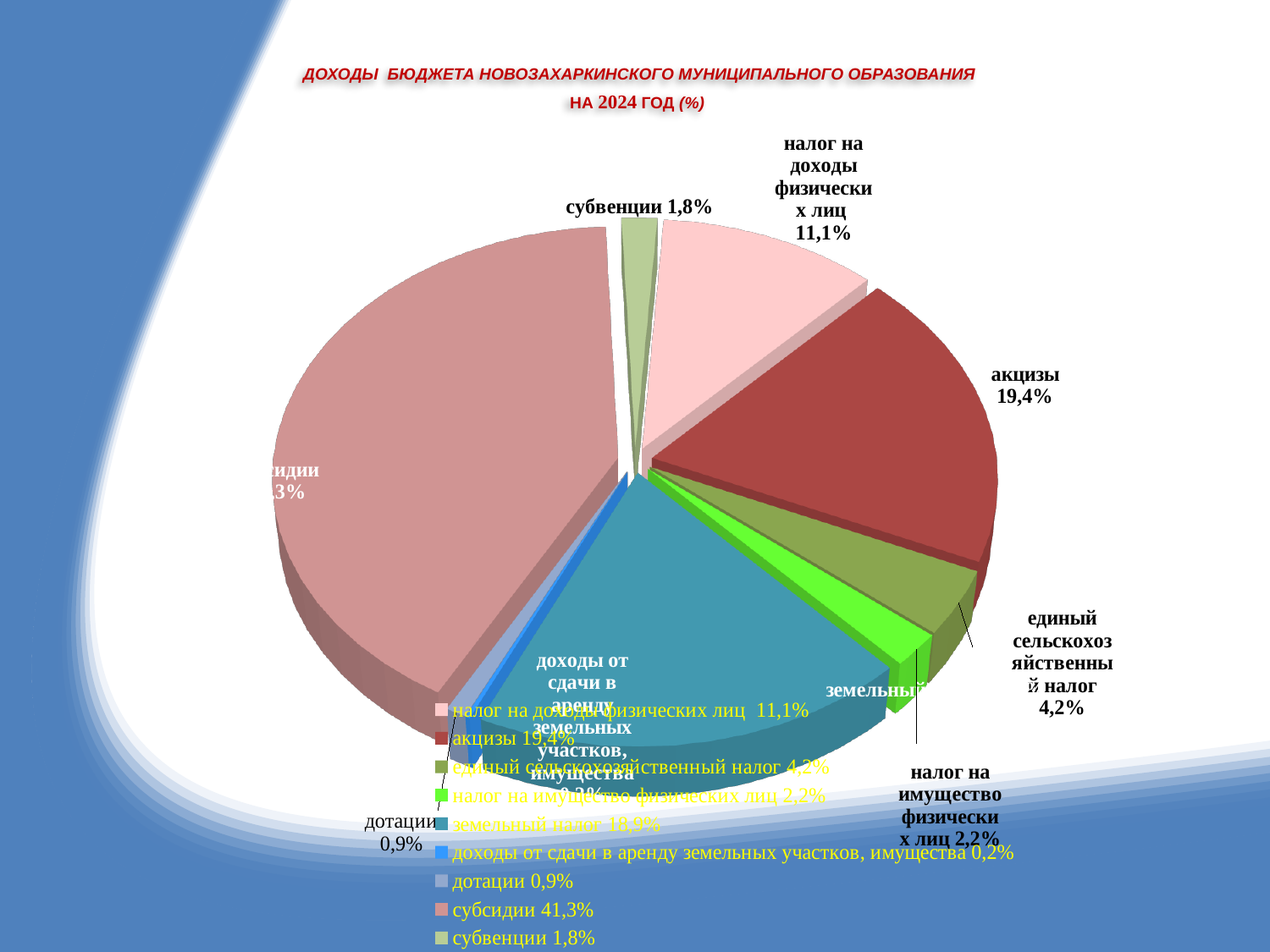
How many categories does the pie chart contain? 9 What percentage is shown for субвенции? 1,8% What is the value for налог на имущество физических лиц? 2,2% What share of the pie does акцизы account for? 19,4% What type of chart is shown on the slide? pie chart What is the value shown for субсидии? 41,3% For which year does the chart show the budget revenues? 2024 Which is larger: the share of акцизы or the share of земельный налог? акцизы Which category has the largest share of the pie? субсидии What is the value for единый сельскохозяйственный налог? 4,2% Which category has the smallest share of the pie? доходы от сдачи в аренду земельных участков, имущества What is the difference between the shares of акцизы and налог на доходы физических лиц? 8,3%